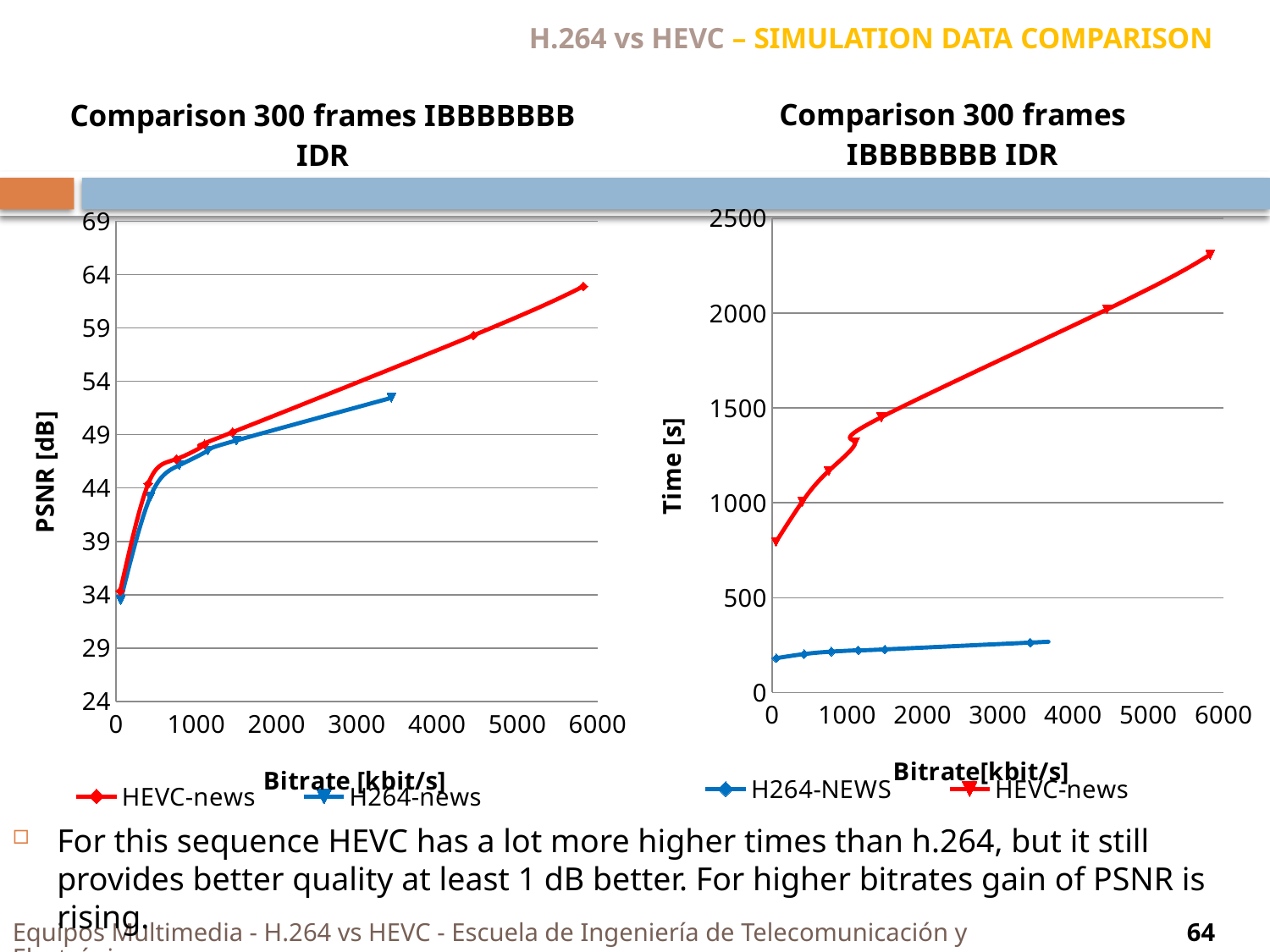
In the left chart, is the PSNR of H264-news at its highest bitrate greater or less than 54? less In the right chart, which series has the higher time at a bitrate of 3000 kbit/s, H264-NEWS or HEVC-news? HEVC-news What is the label of the y axis of the right chart? Time [s] How many series does the legend of the left chart list? 2 In the left chart, is the PSNR of HEVC-news at its highest bitrate greater or less than 59? greater What kind of chart is the right chart on the slide? line chart What kind of chart is the left chart on the slide? line chart In the right chart, is the time for HEVC-news at its highest bitrate greater or less than 2000? greater In the left chart, does the PSNR of HEVC-news rise or fall as bitrate increases? rise How many series does the legend of the right chart list? 2 In the right chart, does the time for HEVC-news rise or fall as bitrate increases? rise